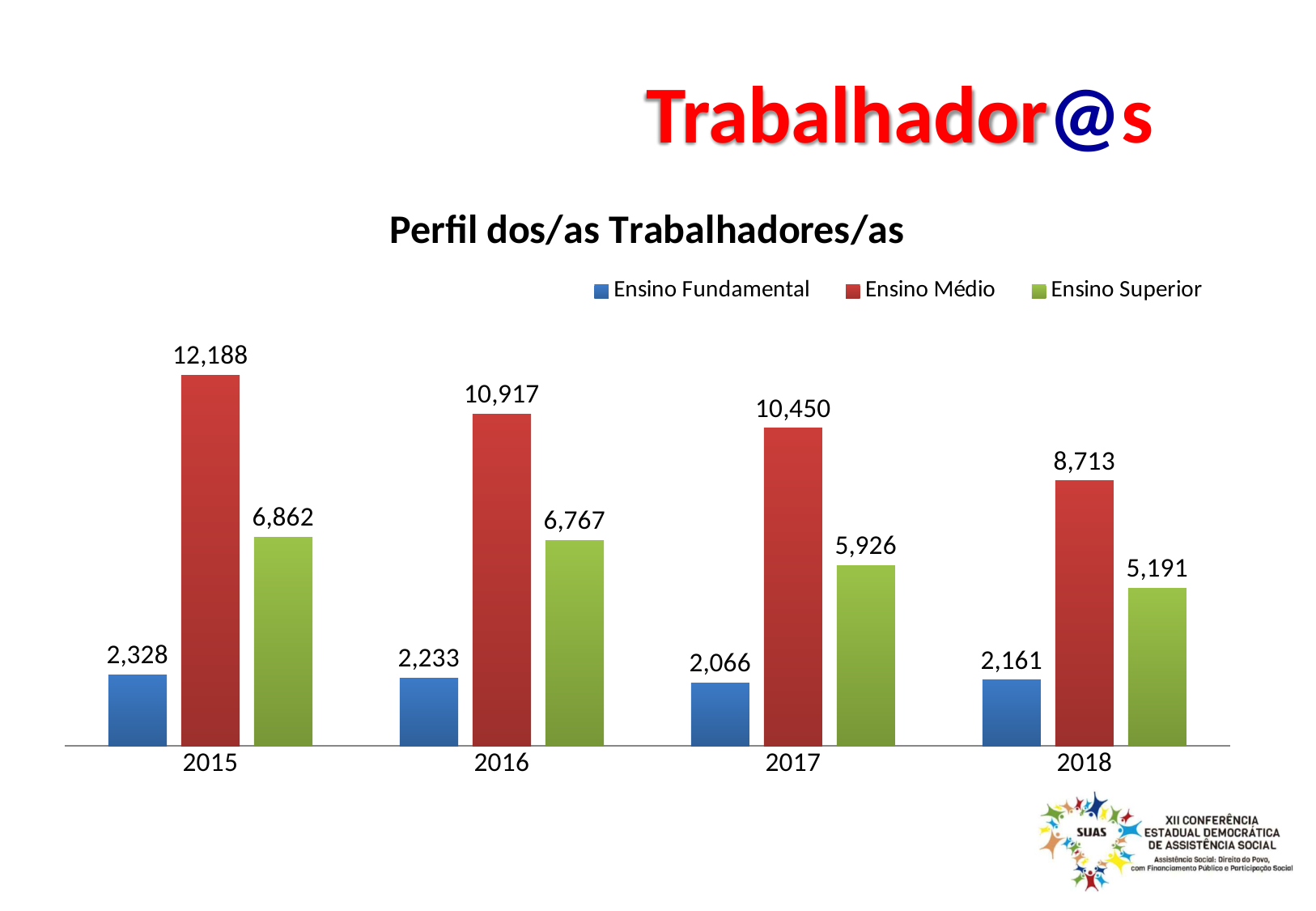
In which year is the Ensino Fundamental value lowest? 2017 In which year is the Ensino Médio value highest? 2015 How many series does the legend list? 3 How many years are shown on the x axis? 4 What is the difference between the Ensino Médio values for 2015 and 2018? 3,475 Which is larger: Ensino Superior in 2016 or Ensino Superior in 2017? Ensino Superior in 2016 What is the value for Ensino Médio in 2015? 12,188 What kind of chart is shown? Bar chart What is the value for Ensino Fundamental in 2017? 2,066 Do the Ensino Médio values rise or fall from 2015 to 2018? Fall What is the value for Ensino Superior in 2018? 5,191 What is the title of the chart? Perfil dos/as Trabalhadores/as